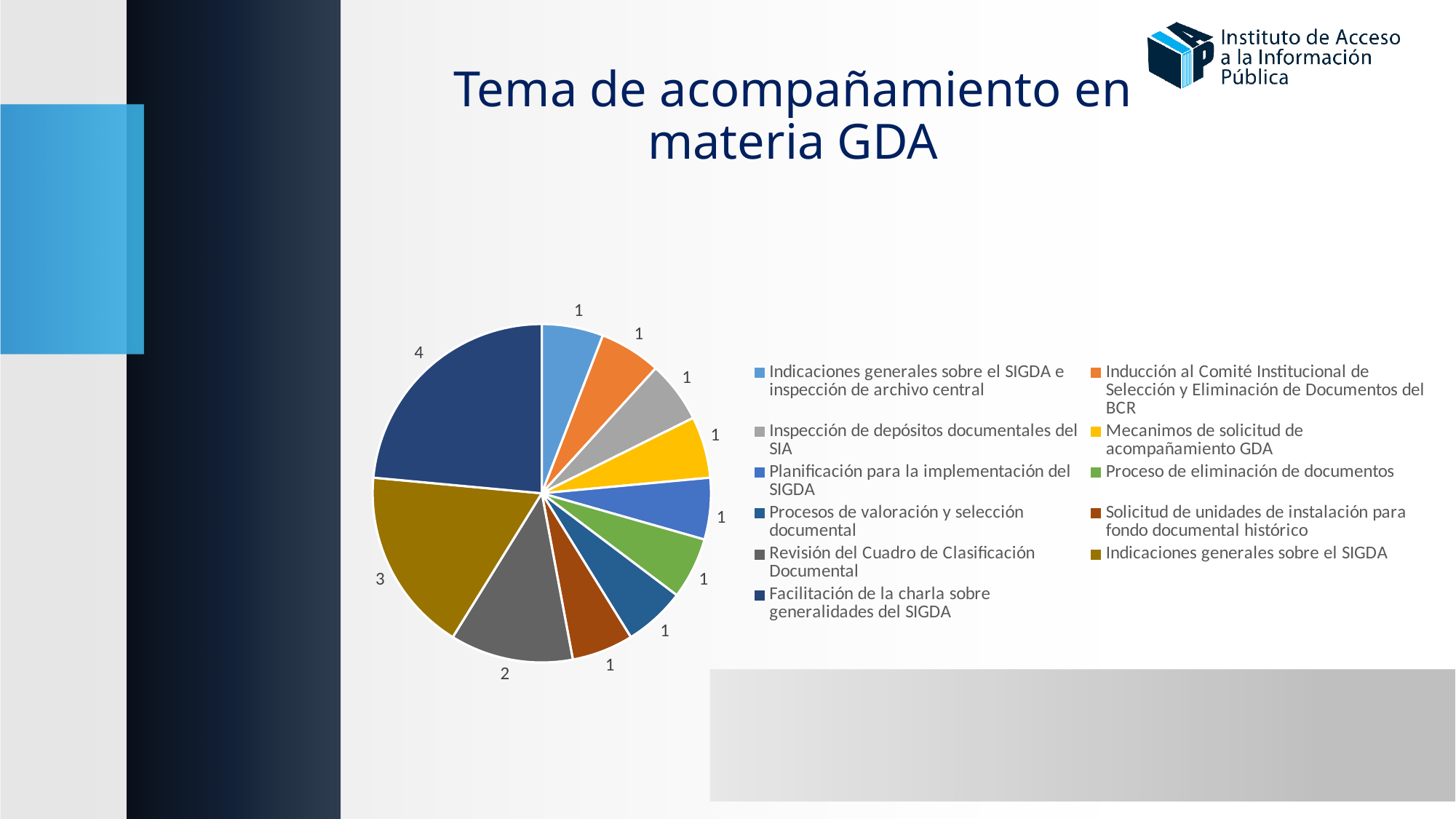
What is the value for 'Proceso de eliminación de documentos'? 1 What type of chart is shown on the slide? pie chart Which is larger: the value for 'Indicaciones generales sobre el SIGDA' or the value for 'Revisión del Cuadro de Clasificación Documental'? Indicaciones generales sobre el SIGDA What is the value for 'Revisión del Cuadro de Clasificación Documental'? 2 How many slices does the pie chart have? 11 What is the title of the slide containing the pie chart? Tema de acompañamiento en materia GDA Which category has the largest slice in the pie chart? Facilitación de la charla sobre generalidades del SIGDA What is the value for 'Indicaciones generales sobre el SIGDA'? 3 What is the value for 'Facilitación de la charla sobre generalidades del SIGDA'? 4 What is the total of all the values shown in the pie chart? 17 What is the difference between the values for 'Facilitación de la charla sobre generalidades del SIGDA' and 'Revisión del Cuadro de Clasificación Documental'? 2 How many entries does the legend of the pie chart list? 11